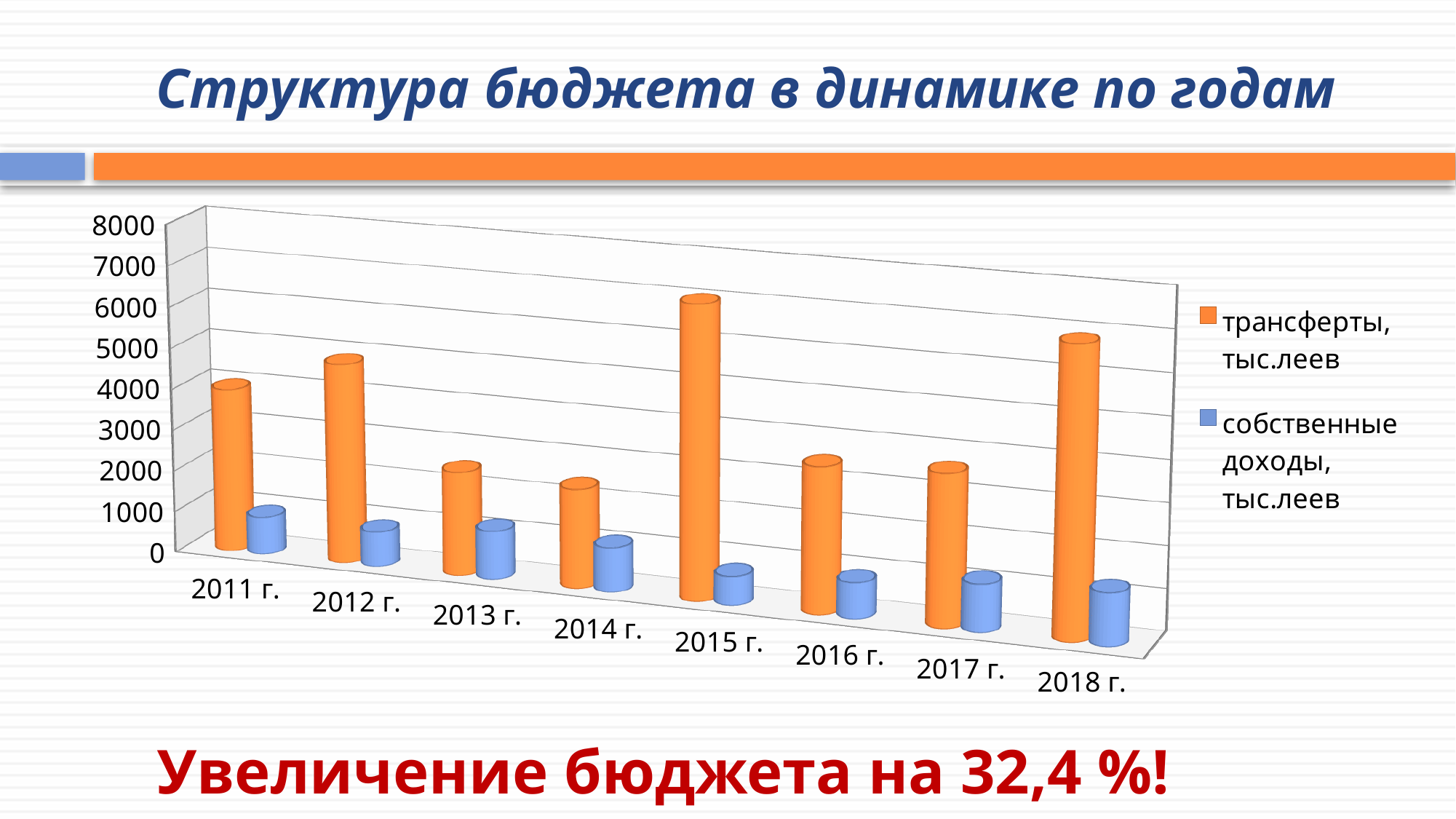
What is the title of the slide containing the chart? Структура бюджета в динамике по годам Which is larger for трансферты, тыс.леев: the value in 2015 г. or in 2014 г.? 2015 г. Which colour represents собственные доходы, тыс.леев in the chart? blue Is the value for трансферты, тыс.леев in 2018 г. greater or less than 3000? greater What kind of chart is shown on the slide? bar chart Is the value for собственные доходы, тыс.леев in 2011 г. greater or less than 2000? less In 2011 г., which series has the larger value: трансферты, тыс.леев or собственные доходы, тыс.леев? трансферты, тыс.леев Is the value for трансферты, тыс.леев in 2015 г. greater or less than 4000? greater How many series does the chart legend list? 2 How many years are shown on the x axis of the chart? 8 In which year is the value for трансферты, тыс.леев the highest? 2015 г.